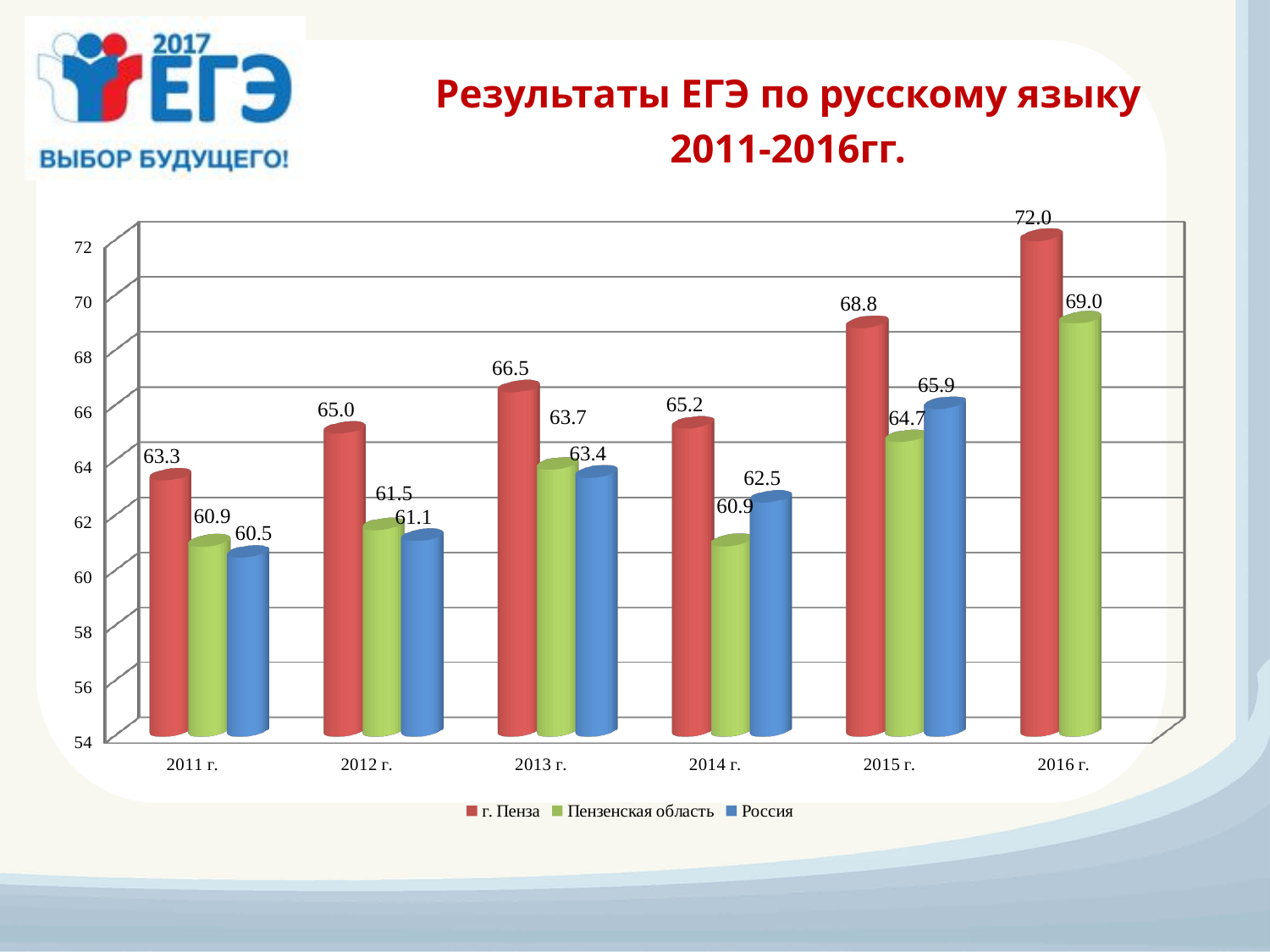
What is the value for г. Пенза in 2016 г.? 72.0 How many series does the legend list? 3 Which is larger in 2014 г.: Пензенская область or Россия? Россия What type of chart is shown on the slide? bar chart In which year is the value for Россия the lowest? 2011 г. Does the value for г. Пенза rise or fall from 2011 г. to 2013 г.? rise Which series is shown in red? г. Пенза What is the value for Россия in 2015 г.? 65.9 What is the difference between г. Пенза and Пензенская область in 2015 г.? 4.1 What is the value for Пензенская область in 2013 г.? 63.7 How many year categories are shown on the x axis? 6 In which year is the value for г. Пенза the highest? 2016 г.